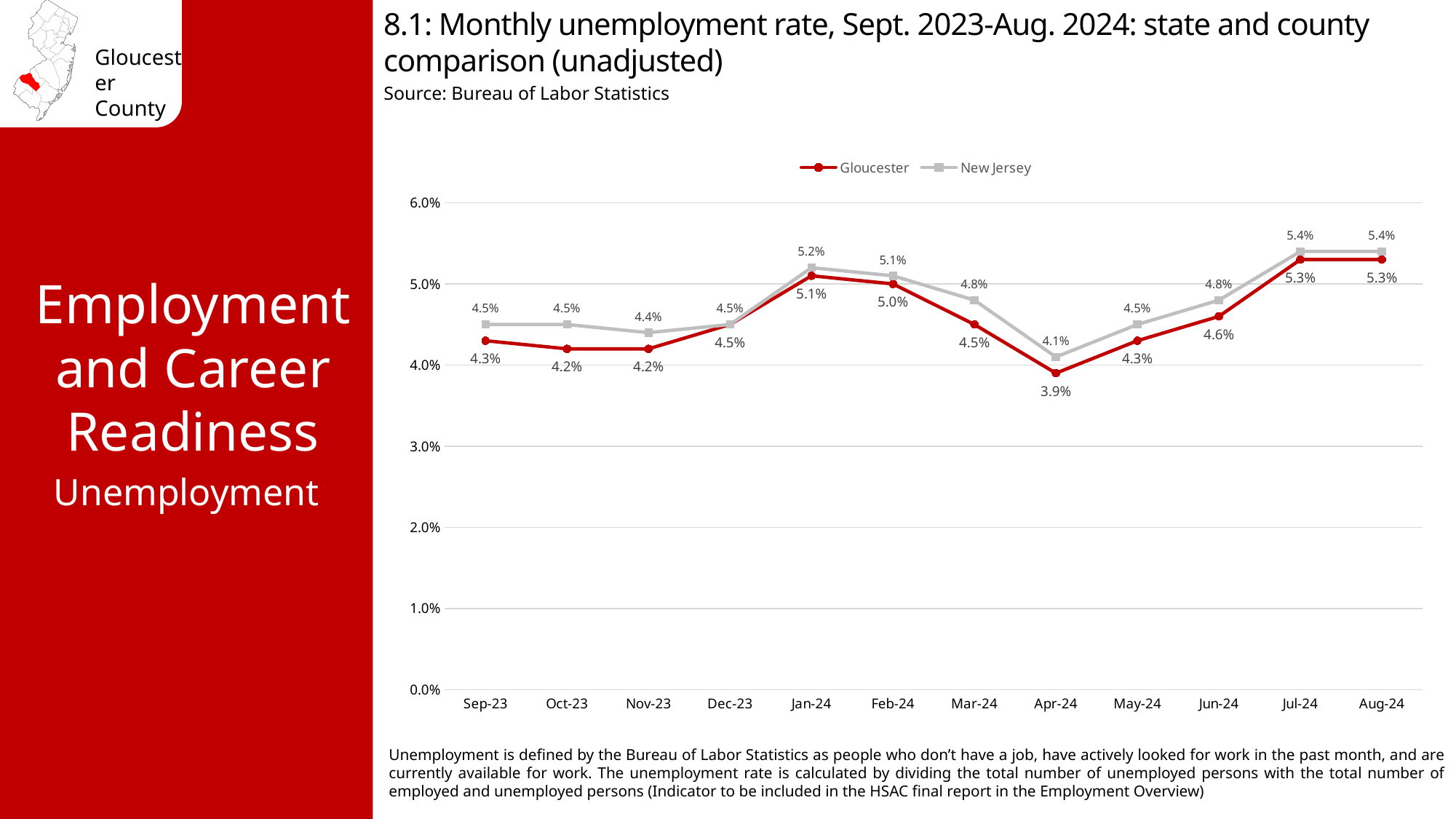
How many series does the legend list? 2 How many months are plotted on the x axis? 12 What is the Gloucester unemployment rate for Jun-24? 4.6% Does the Gloucester unemployment rate rise or fall from Apr-24 to Jul-24? Rise What kind of chart is shown on the slide? Line chart What is the New Jersey unemployment rate for Jan-24? 5.2% Which series has the higher unemployment rate in Sep-23, Gloucester or New Jersey? New Jersey What is the difference between the New Jersey and Gloucester unemployment rates in Mar-24? 0.3% What is the Gloucester unemployment rate for Apr-24? 3.9% In which month is the New Jersey unemployment rate lowest? Apr-24 In which month is the Gloucester unemployment rate lowest? Apr-24 What is the difference between the Gloucester unemployment rate in Jul-24 and in Apr-24? 1.4%